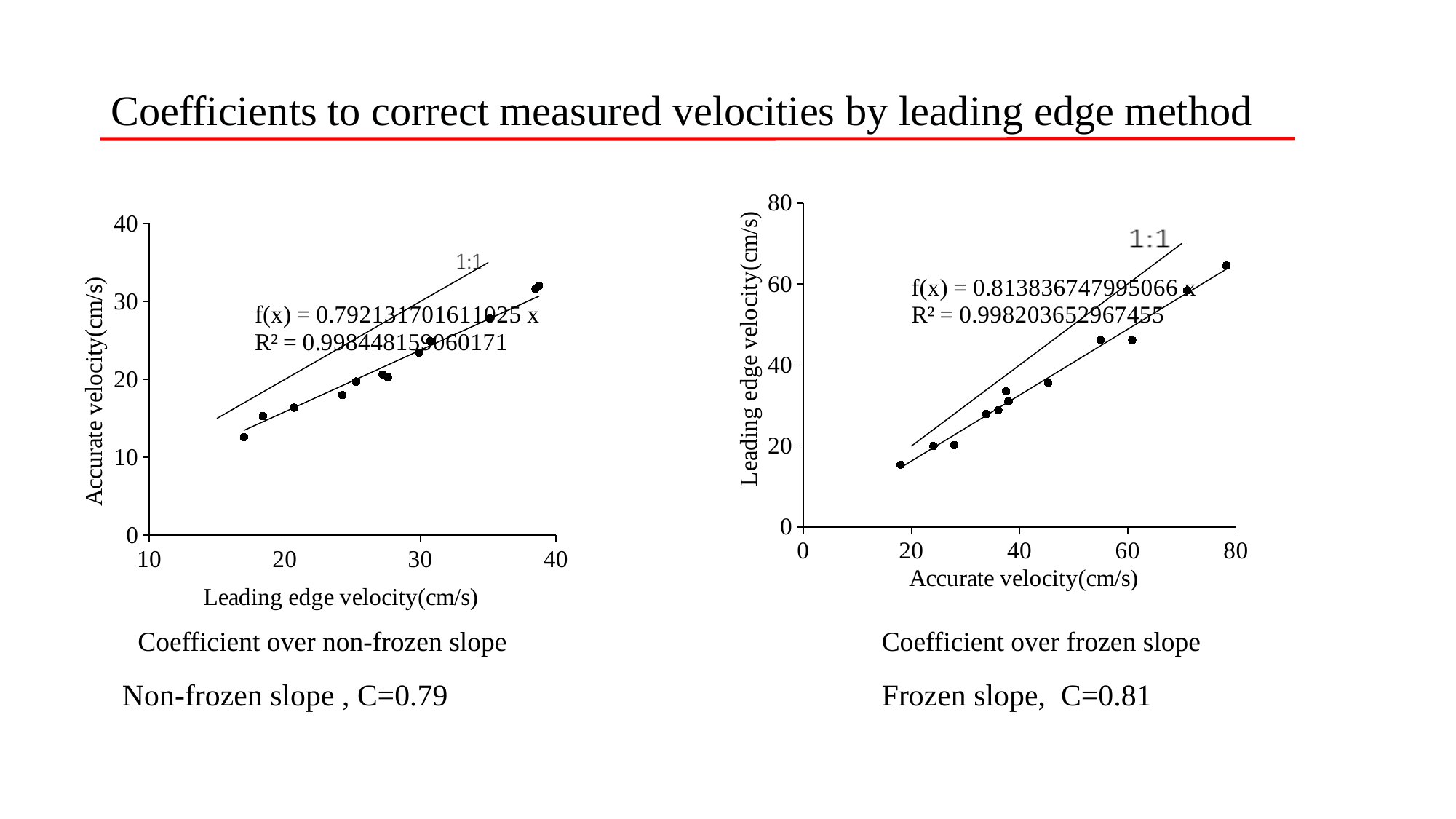
In the 'Coefficient over non-frozen slope' chart, what is the fitted equation f(x) shown? f(x) = 0.792131701611025 x In the 'Coefficient over non-frozen slope' chart, what is the R² value shown? R² = 0.998448159060171 In the 'Coefficient over frozen slope' chart, is the leading edge velocity of the rightmost point greater or less than 60? greater In the 'Coefficient over non-frozen slope' chart, is the accurate velocity of the leftmost point greater or less than 20? less In the 'Coefficient over frozen slope' chart, what is the R² value shown? R² = 0.998203652967455 In the 'Coefficient over frozen slope' chart, what is the fitted equation f(x) shown? f(x) = 0.813836747995066 x What is the y-axis label of the 'Coefficient over frozen slope' chart? Leading edge velocity(cm/s) Which chart has the larger fitted slope, 'Coefficient over non-frozen slope' or 'Coefficient over frozen slope'? Coefficient over frozen slope What is the x-axis label of the 'Coefficient over non-frozen slope' chart? Leading edge velocity(cm/s) What kind of chart is the 'Coefficient over non-frozen slope' chart? scatter chart In the 'Coefficient over non-frozen slope' chart, do the plotted values rise or fall as leading edge velocity increases? rise In the 'Coefficient over frozen slope' chart, do the plotted values rise or fall as accurate velocity increases? rise